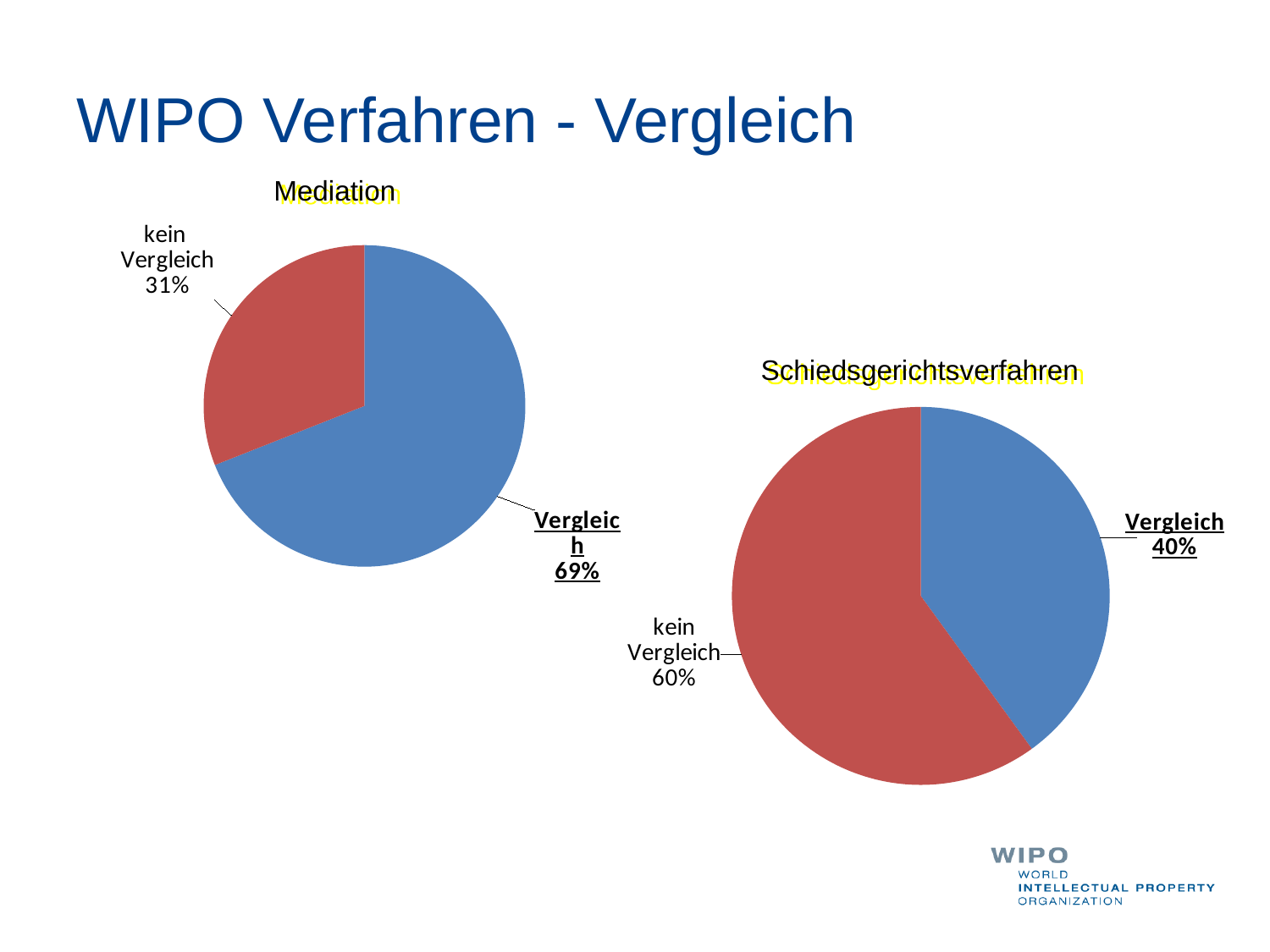
How many slices does the Mediation pie chart have? 2 In the Mediation chart, what share is labelled kein Vergleich? 31% In the Mediation chart, what share is labelled Vergleich? 69% In the Mediation chart, which slice is the largest? Vergleich In the Schiedsgerichtsverfahren chart, what colour is the kein Vergleich slice? Red In the Schiedsgerichtsverfahren chart, what is the difference between the kein Vergleich and Vergleich shares? 20% In the Mediation chart, what is the difference between the Vergleich and kein Vergleich shares? 38% In the Schiedsgerichtsverfahren chart, what share is labelled Vergleich? 40% Which chart has the larger Vergleich share, Mediation or Schiedsgerichtsverfahren? Mediation In the Schiedsgerichtsverfahren chart, what share is labelled kein Vergleich? 60% What type of chart is the Schiedsgerichtsverfahren chart? Pie chart In the Schiedsgerichtsverfahren chart, which slice is the smallest? Vergleich